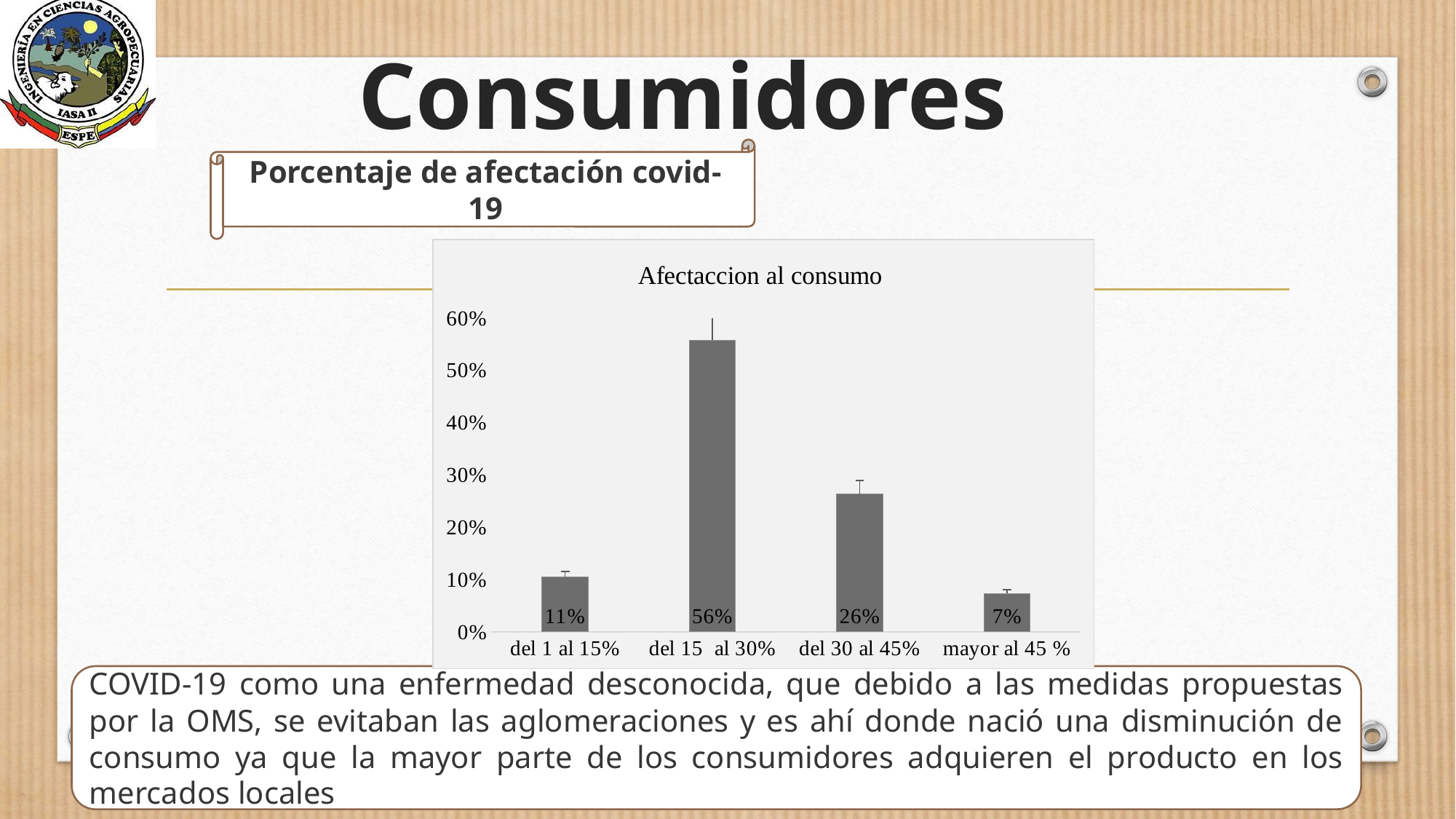
What is the difference between the values for 'del 15 al 30%' and 'del 30 al 45%' in the Afectaccion al consumo chart? 30% Which category has the highest value in the Afectaccion al consumo chart? del 15 al 30% What is the value for 'del 30 al 45%' in the Afectaccion al consumo chart? 26% Which is larger in the Afectaccion al consumo chart: the value for 'del 1 al 15%' or 'mayor al 45 %'? del 1 al 15% What is the value for 'del 1 al 15%' in the Afectaccion al consumo chart? 11% What is the title of the chart on the slide? Afectaccion al consumo How many categories are shown in the Afectaccion al consumo chart? 4 What kind of chart is the Afectaccion al consumo chart? bar chart Is the value for 'del 30 al 45%' greater or less than 30% in the Afectaccion al consumo chart? less What is the value for 'del 15 al 30%' in the Afectaccion al consumo chart? 56% Which category has the lowest value in the Afectaccion al consumo chart? mayor al 45 % What is the value for 'mayor al 45 %' in the Afectaccion al consumo chart? 7%